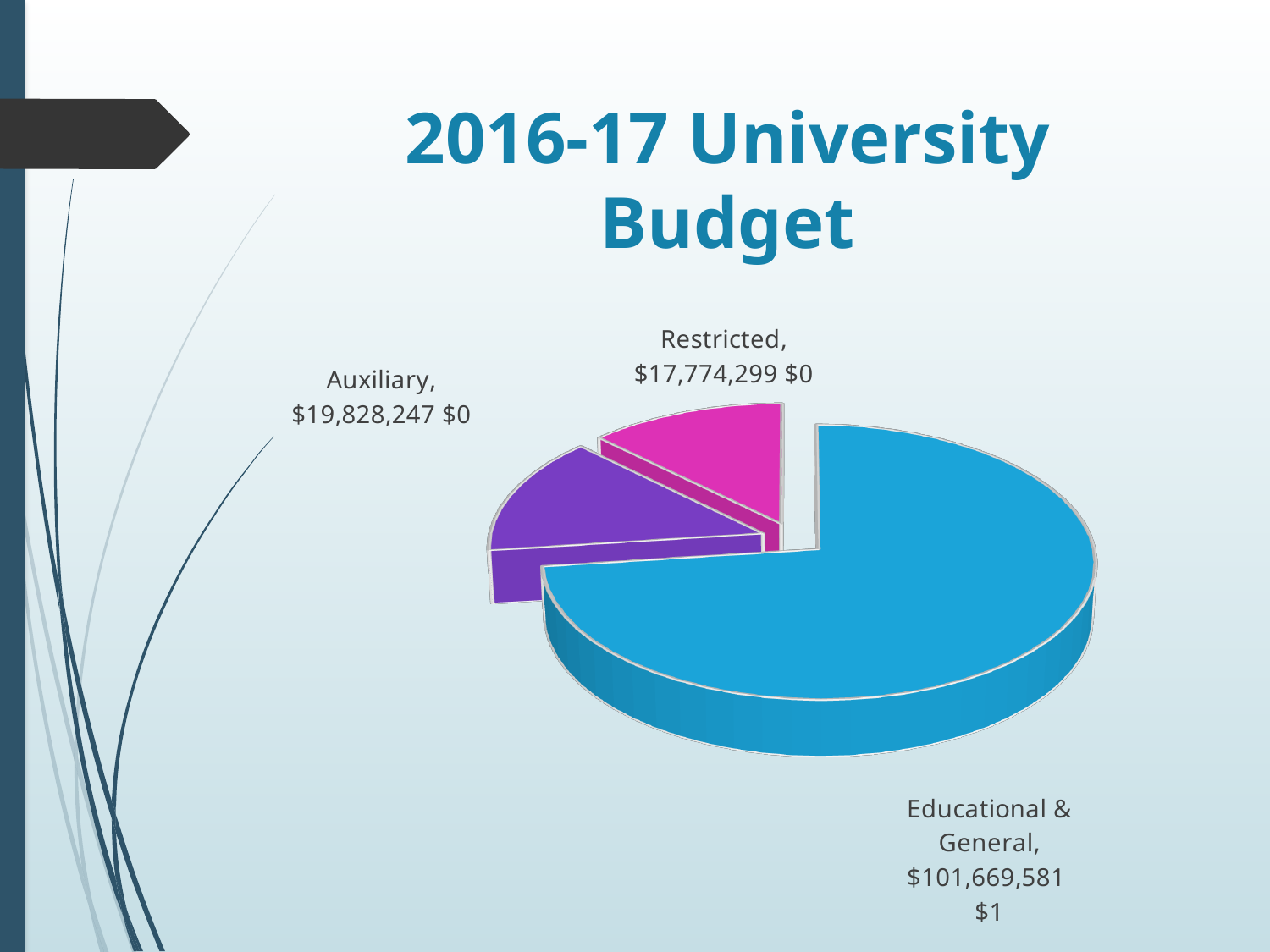
What is the title of the chart on the slide? 2016-17 University Budget Which category has the smallest slice of the pie? Restricted What type of chart is shown on the slide? Pie chart What is the value for Auxiliary? $19,828,247 What is the difference between the Educational & General and Auxiliary values? $81,841,334 What is the difference between the Auxiliary and Restricted values? $2,053,948 What is the value for Educational & General? $101,669,581 Which is larger, Auxiliary or Restricted? Auxiliary What colour is the Educational & General slice? Blue How many slices does the pie chart have? 3 Which category has the largest slice of the pie? Educational & General What is the value for Restricted? $17,774,299